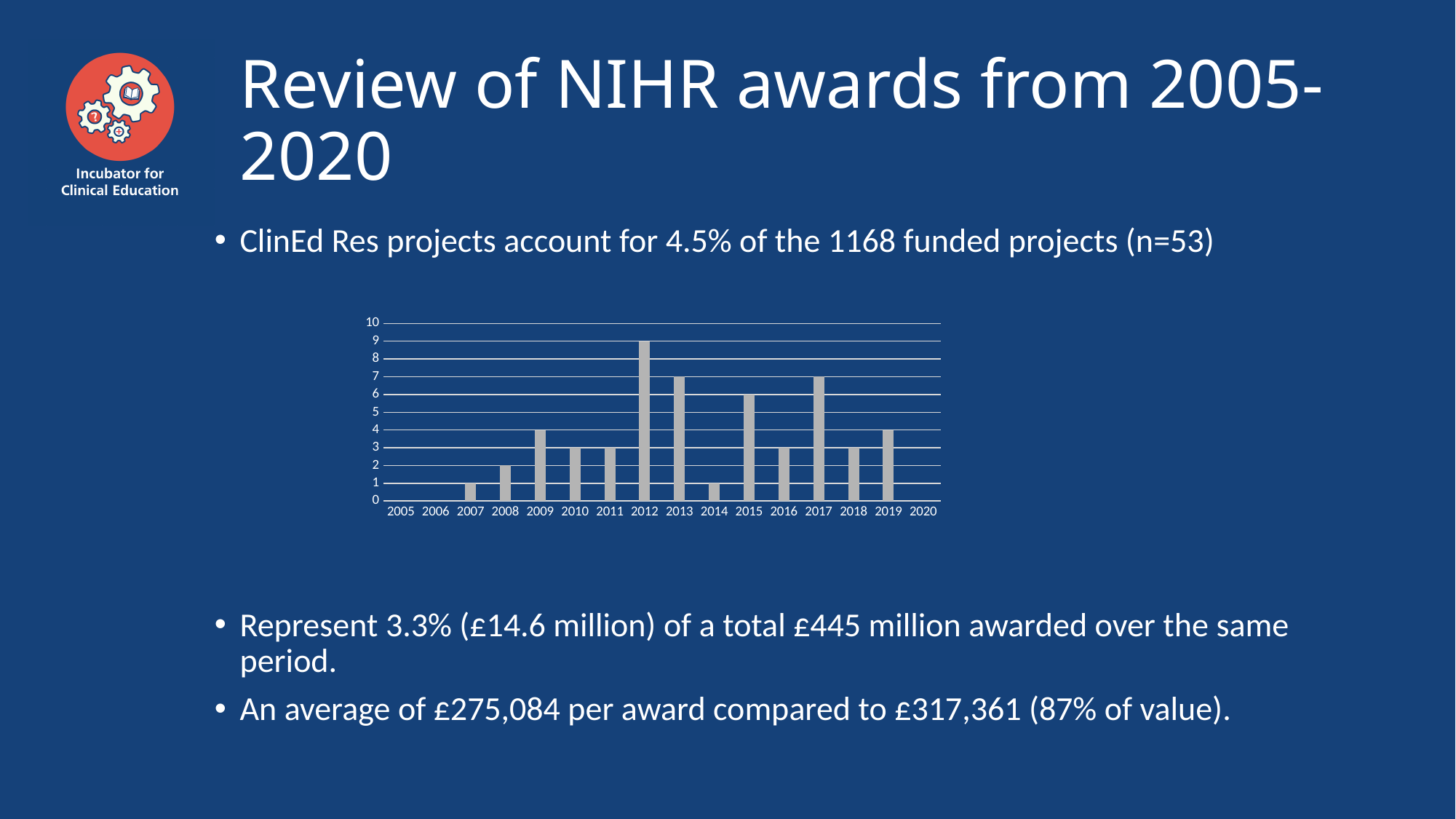
What kind of chart is shown on the slide? bar chart What is the value for 2009 in the chart? 4 What is the difference between the values for 2012 and 2013 in the chart? 2 How many years are shown along the x axis of the chart? 16 What is the value for 2015 in the chart? 6 Which is larger in the chart, the value for 2017 or the value for 2018? 2017 Is the value for 2014 greater or less than 5? less What is the value for 2012 in the chart? 9 What is the highest value shown on the y axis of the chart? 10 Which year has the highest bar in the chart? 2012 What is the value for 2007 in the chart? 1 Is the value for 2013 greater or less than 5? greater